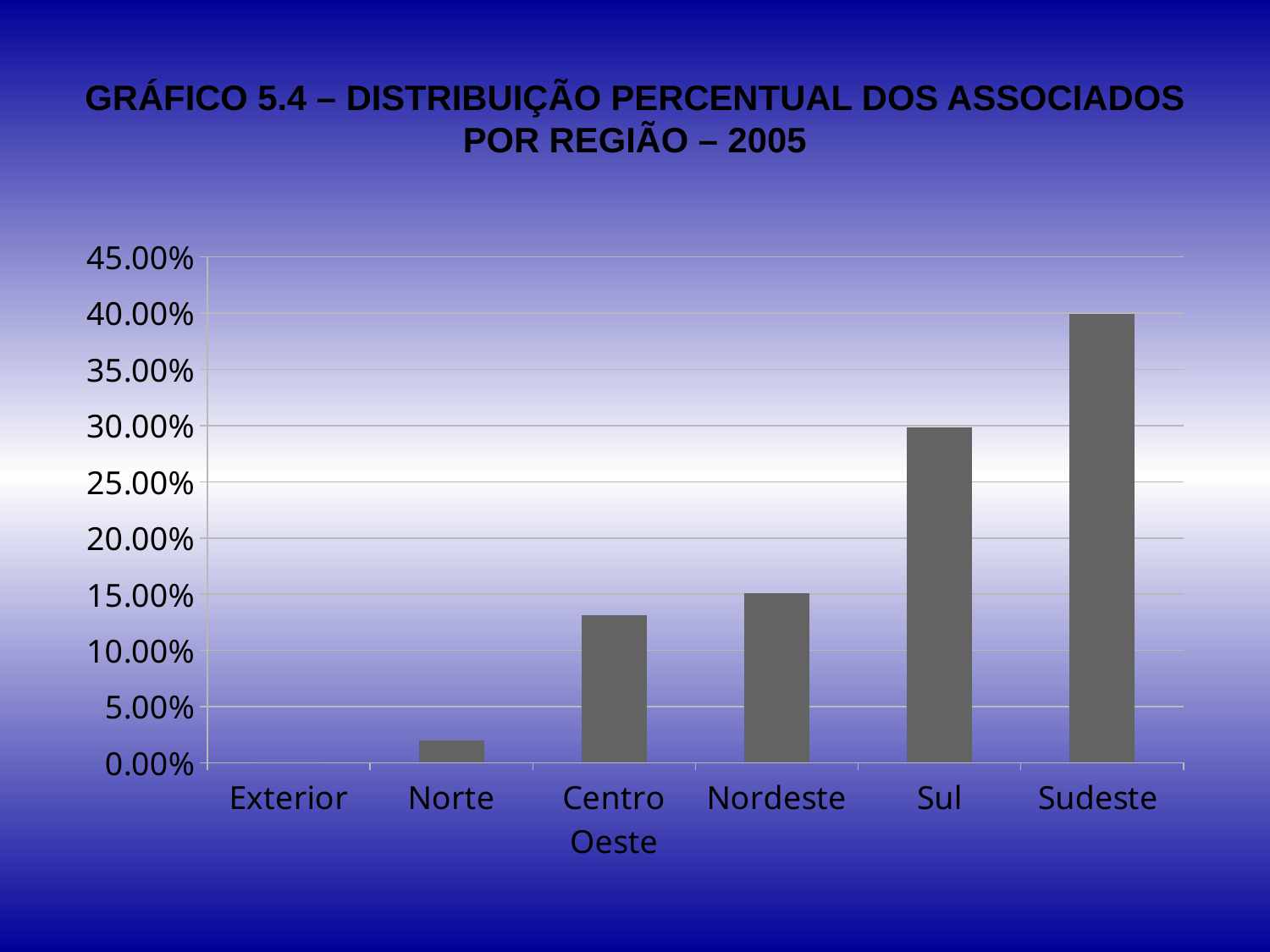
Which region has the highest percentage of associados? Sudeste What kind of chart is shown on the slide? bar chart Is the value for Sul greater or less than 25.00%? greater Do the values rise or fall moving from Exterior to Sudeste along the x axis? rise What year does the chart title refer to? 2005 Is the value for Centro Oeste greater or less than 10.00%? greater Is the value for Sul greater or less than 35.00%? less Which region has the lowest percentage of associados? Exterior How many regions (categories) are shown on the x axis? 6 Which is larger, the value for Sul or the value for Nordeste? Sul